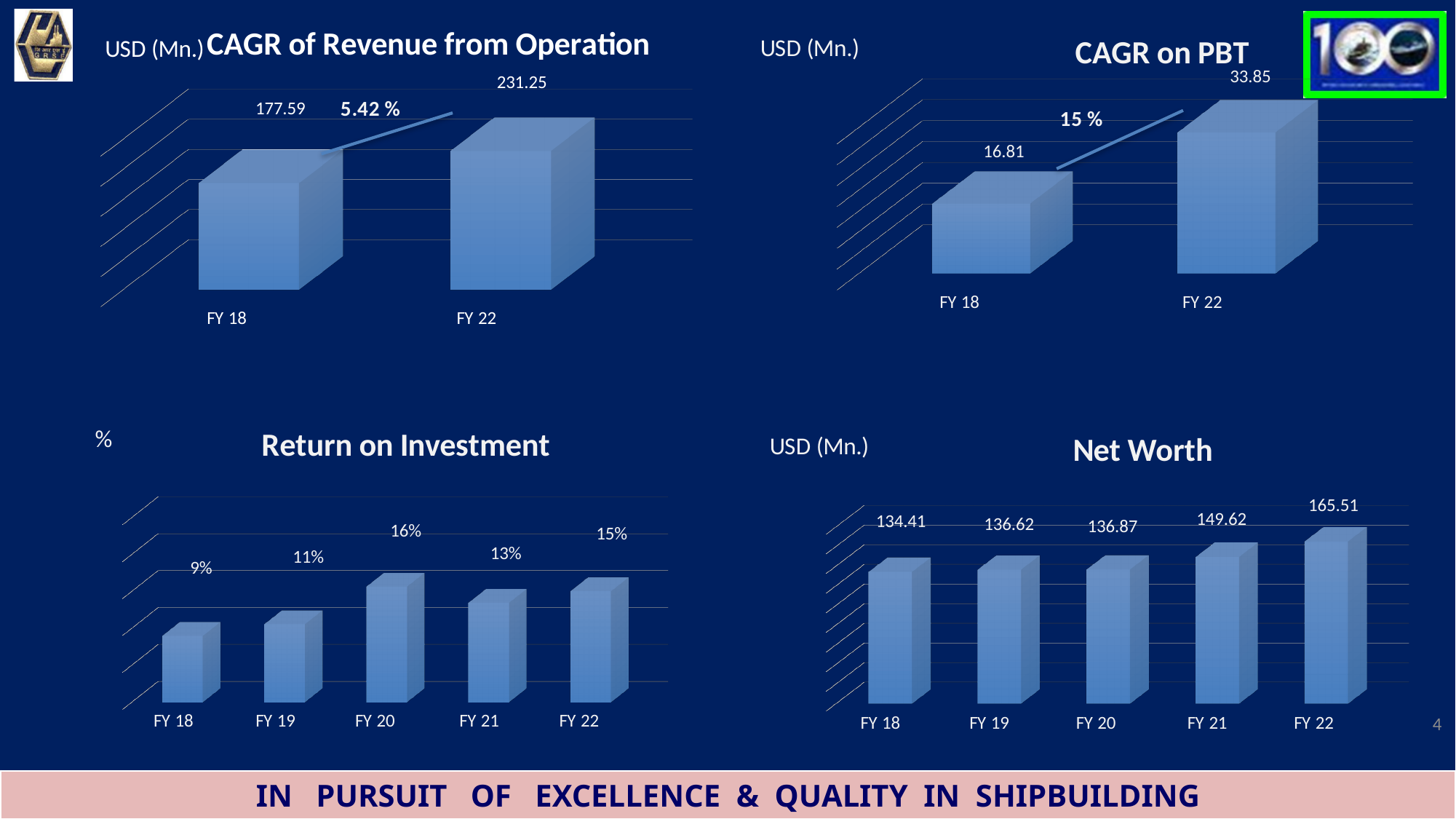
In the 'Net Worth' chart, what is the difference between the FY 22 and FY 18 values? 31.10 In the 'Net Worth' chart, what is the value for FY 21? 149.62 In the 'CAGR on PBT' chart, which fiscal year has the higher value? FY 22 In the 'Return on Investment' chart, how many fiscal years are plotted? 5 In the 'CAGR on PBT' chart, what CAGR percentage is annotated between FY 18 and FY 22? 15 % In the 'Return on Investment' chart, which fiscal year has the lowest value? FY 18 In the 'Net Worth' chart, which fiscal year has the highest value? FY 22 In the 'CAGR of Revenue from Operation' chart, what is the difference between the FY 22 and FY 18 values? 53.66 In the 'CAGR of Revenue from Operation' chart, what is the value for FY 22? 231.25 In the 'CAGR on PBT' chart, what is the value for FY 18? 16.81 What kind of chart is the 'Net Worth' chart? Bar chart In the 'Return on Investment' chart, what is the value for FY 20? 16%